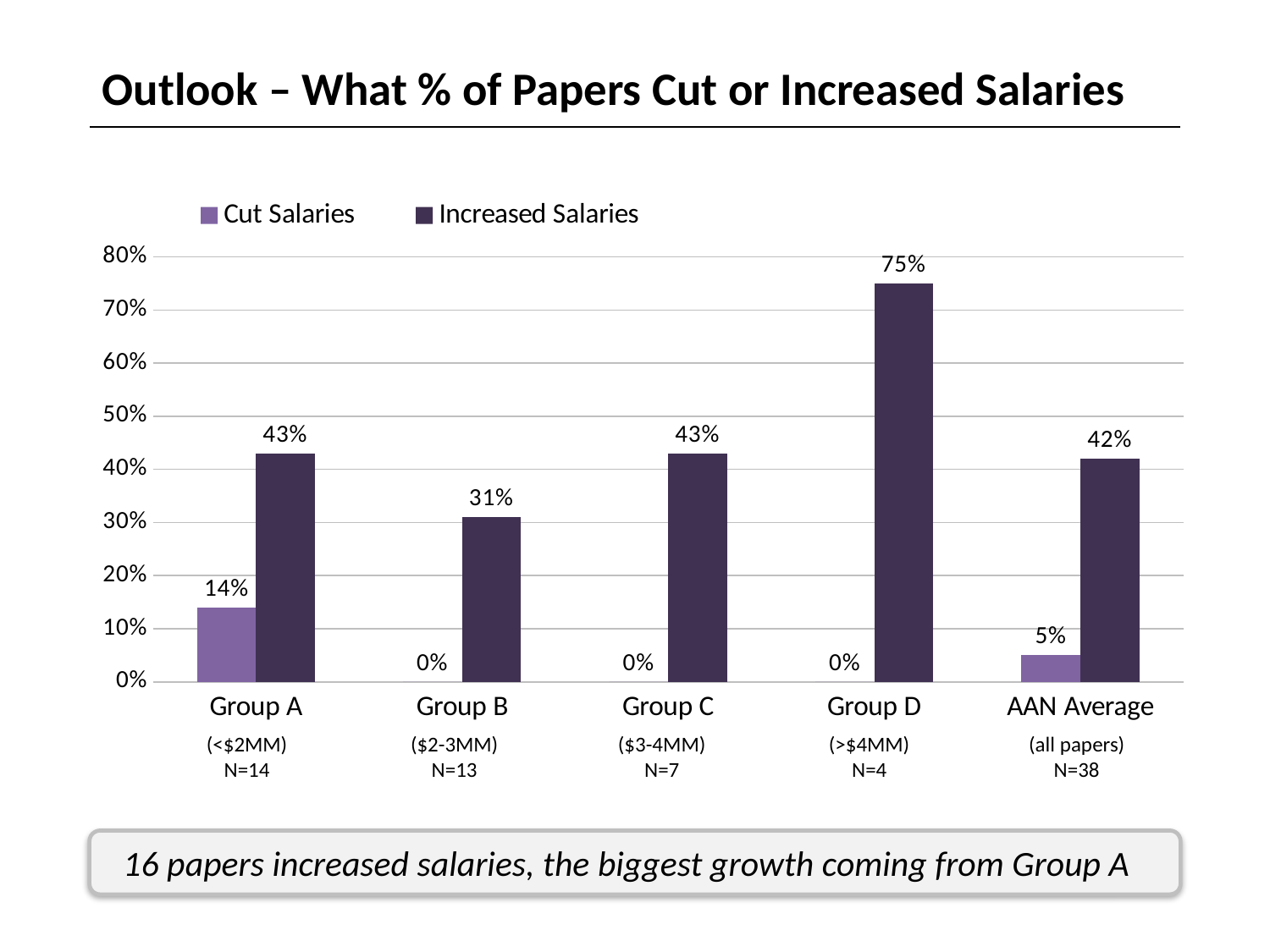
How many series does the legend list? 2 Which group has the highest percentage of papers that increased salaries? Group D Which category has the lowest Increased Salaries value? Group B What is the AAN Average value for Increased Salaries? 42% How many categories are shown on the x axis? 5 What is the difference between the Increased Salaries values for Group D and Group B? 44% What kind of chart is shown on the slide? Bar chart What percentage of Group B papers increased salaries? 31% What percentage of Group A papers cut salaries? 14% What are the two series named in the legend? Cut Salaries and Increased Salaries What percentage of Group D papers increased salaries? 75% Which is larger for Group A: the Cut Salaries value or the Increased Salaries value? Increased Salaries